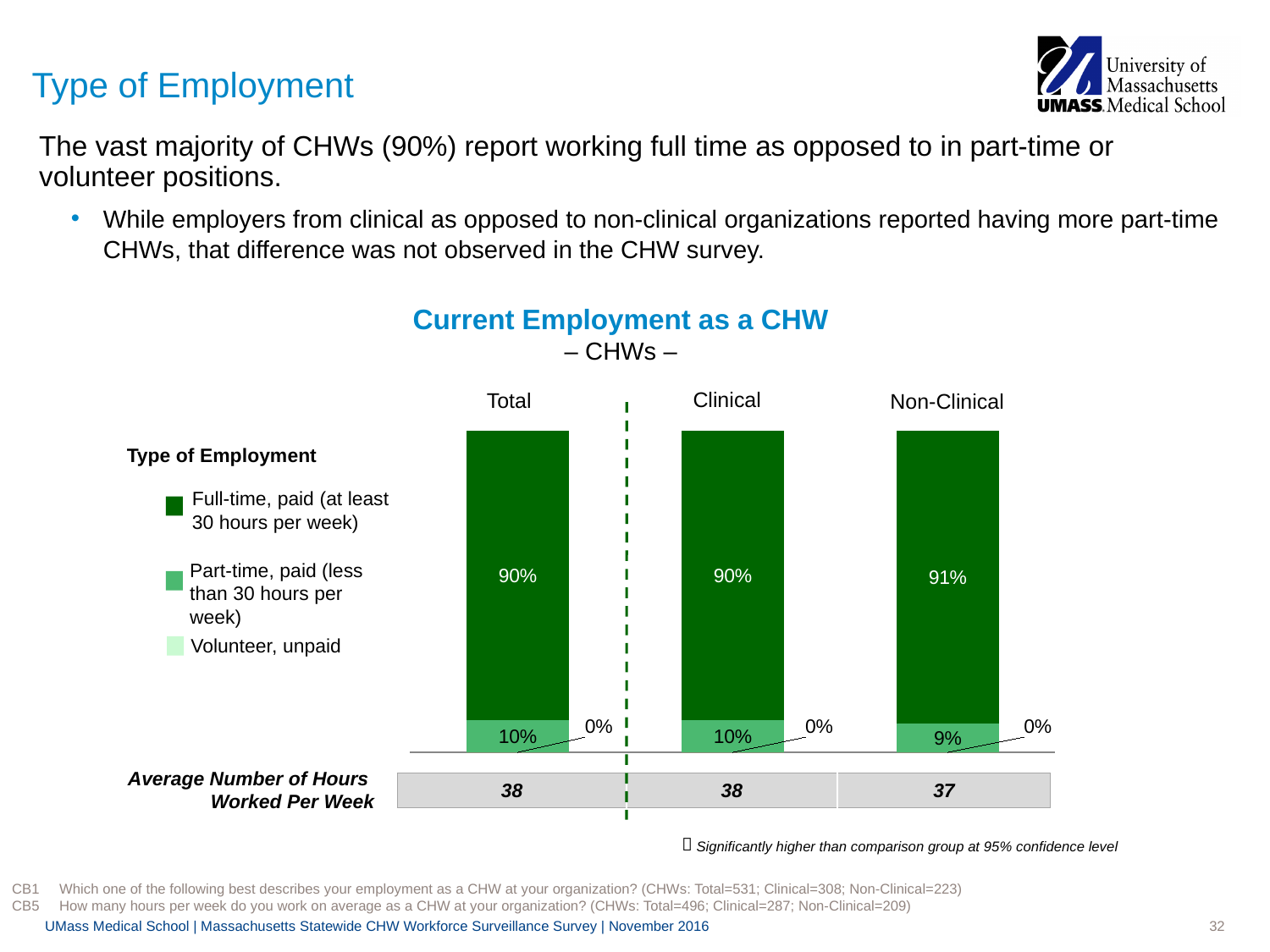
What kind of chart is shown on the slide? Stacked bar chart Is the part-time, paid percentage larger for Clinical or Non-Clinical CHWs? Clinical What percentage of Total CHWs report full-time, paid employment? 90% How many groups (bars) are shown in the chart? 3 What is the title of the chart? Current Employment as a CHW Which group has the lowest percentage of part-time, paid CHWs? Non-Clinical What percentage of Clinical CHWs report being volunteer, unpaid? 0% What percentage of Non-Clinical CHWs report part-time, paid employment? 9% How many types of employment does the legend list? 3 Which group has the highest percentage of full-time, paid CHWs? Non-Clinical What is the average number of hours worked per week for Non-Clinical CHWs? 37 What is the difference between the full-time, paid percentage for Non-Clinical and Clinical CHWs? 1%